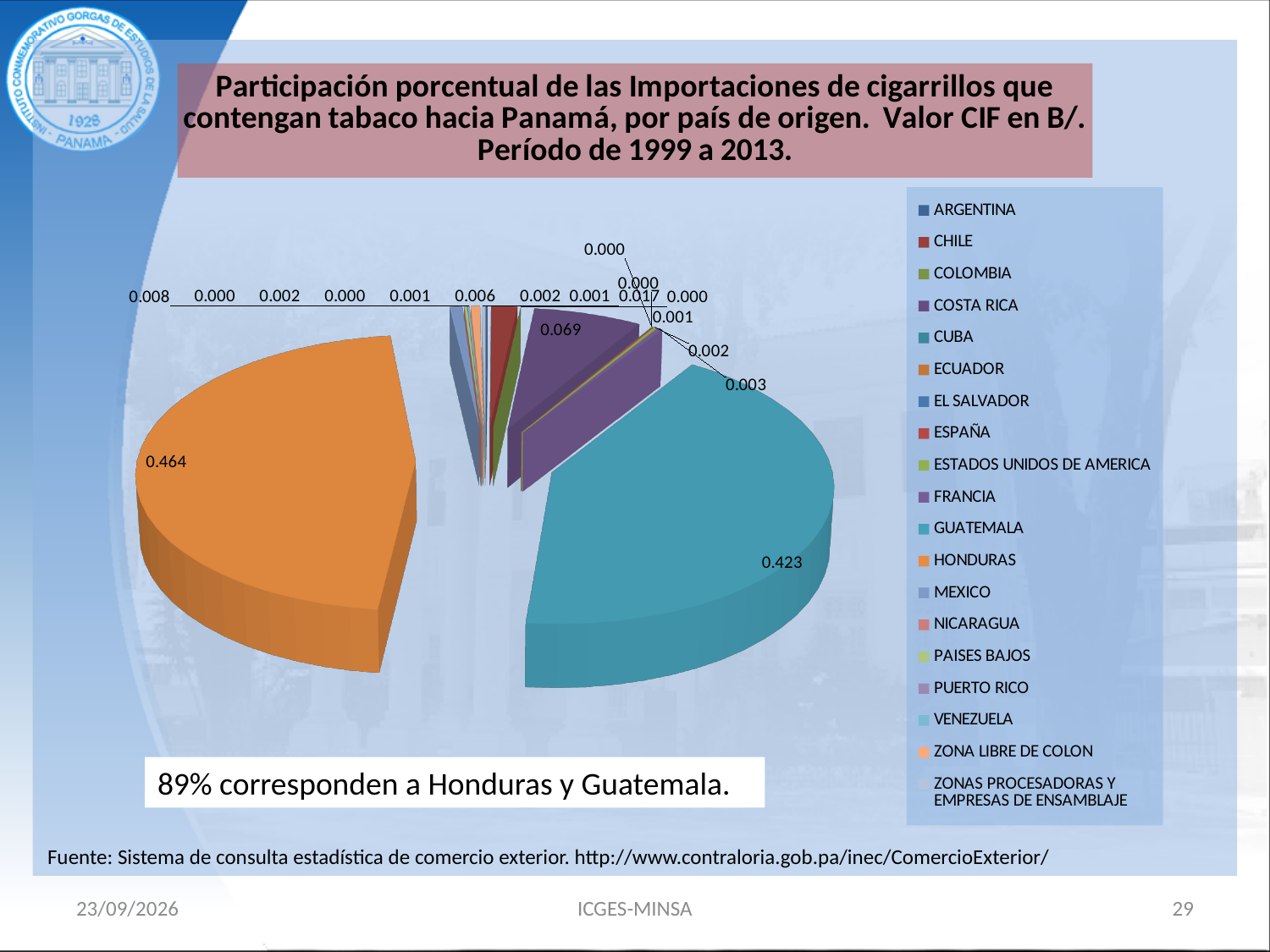
What period does the chart title say the data covers? 1999 a 2013 What is the value shown for Honduras? 0.464 What is the combined value of the Honduras and Guatemala slices? 0.887 Which country has the largest slice of the pie? Honduras Which is larger, the slice for Honduras or the slice for Guatemala? Honduras According to the text box on the slide, what percentage corresponds to Honduras and Guatemala? 89% What kind of chart is shown on the slide? pie chart What is the largest data label value shown on the pie chart? 0.464 How many countries or origins are listed in the chart legend? 19 What is the difference between the values for Honduras and Guatemala? 0.041 What is the value shown for Guatemala? 0.423